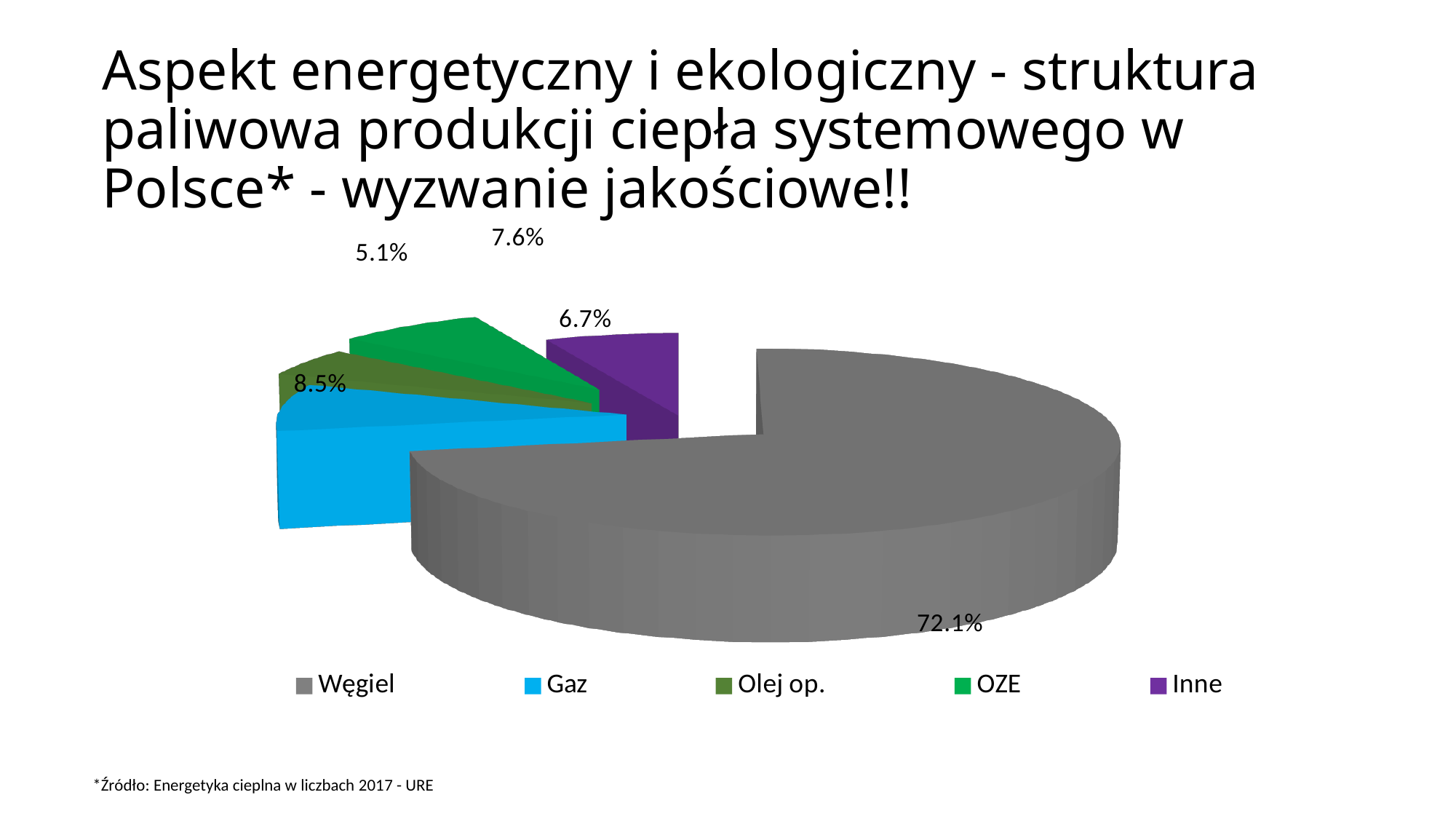
What is the value for Inne? 6.7% What share of the pie does Węgiel have? 72.1% What type of chart is shown on the slide? Pie chart What is the value shown for Gaz? 8.5% Which colour represents Inne in the legend? Purple Which category has the smallest slice of the pie? Olej op. What is the difference between the shares of Węgiel and Gaz? 63.6% How many categories does the pie chart show? 5 What percentage is shown for OZE? 7.6% Which is larger, the share for Gaz or the share for OZE? Gaz What percentage is shown for Olej op.? 5.1% Which category has the largest slice of the pie? Węgiel